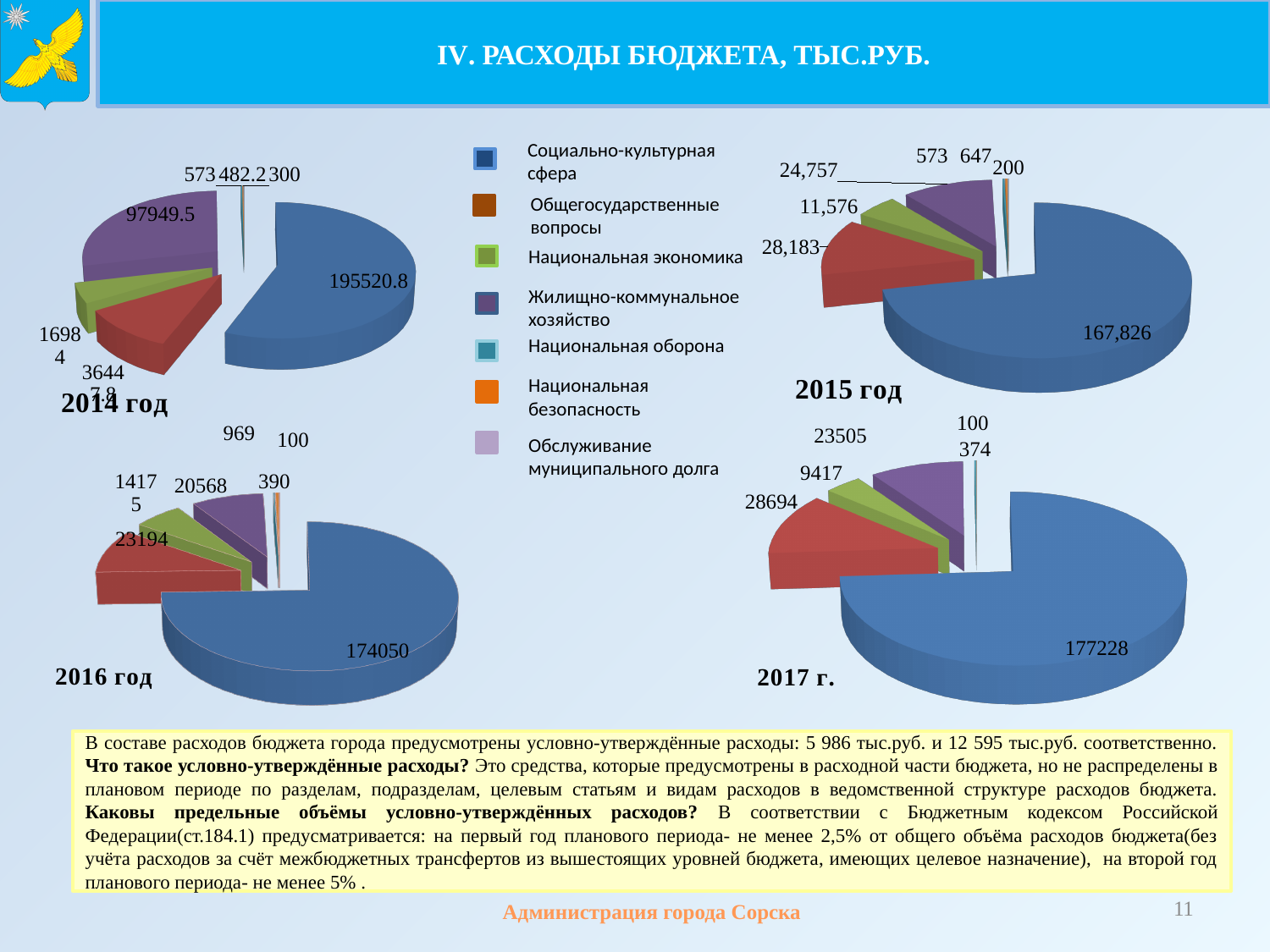
In the 2017 г. chart, what is the difference between Социально-культурная сфера (177228) and Общегосударственные вопросы (28694)? 148534 In the 2014 год chart, what is the value for Жилищно-коммунальное хозяйство? 97949.5 In the 2017 г. chart, what is the value for Жилищно-коммунальное хозяйство? 23505 In the 2015 год chart, what is the value for Социально-культурная сфера? 167,826 In the 2015 год chart, which is larger: Общегосударственные вопросы or Жилищно-коммунальное хозяйство? Общегосударственные вопросы In the 2016 год chart, what is the value for Общегосударственные вопросы? 23194 In the 2014 год chart, what is the value for Социально-культурная сфера? 195520.8 What type of chart is used to show the 2015 год budget expenditures? pie chart How many pie charts are shown on the slide? 4 In the 2015 год chart, what is the value for Национальная экономика? 11,576 In the 2017 г. chart, which category has the largest slice? Социально-культурная сфера How many expenditure categories does the shared legend list? 7